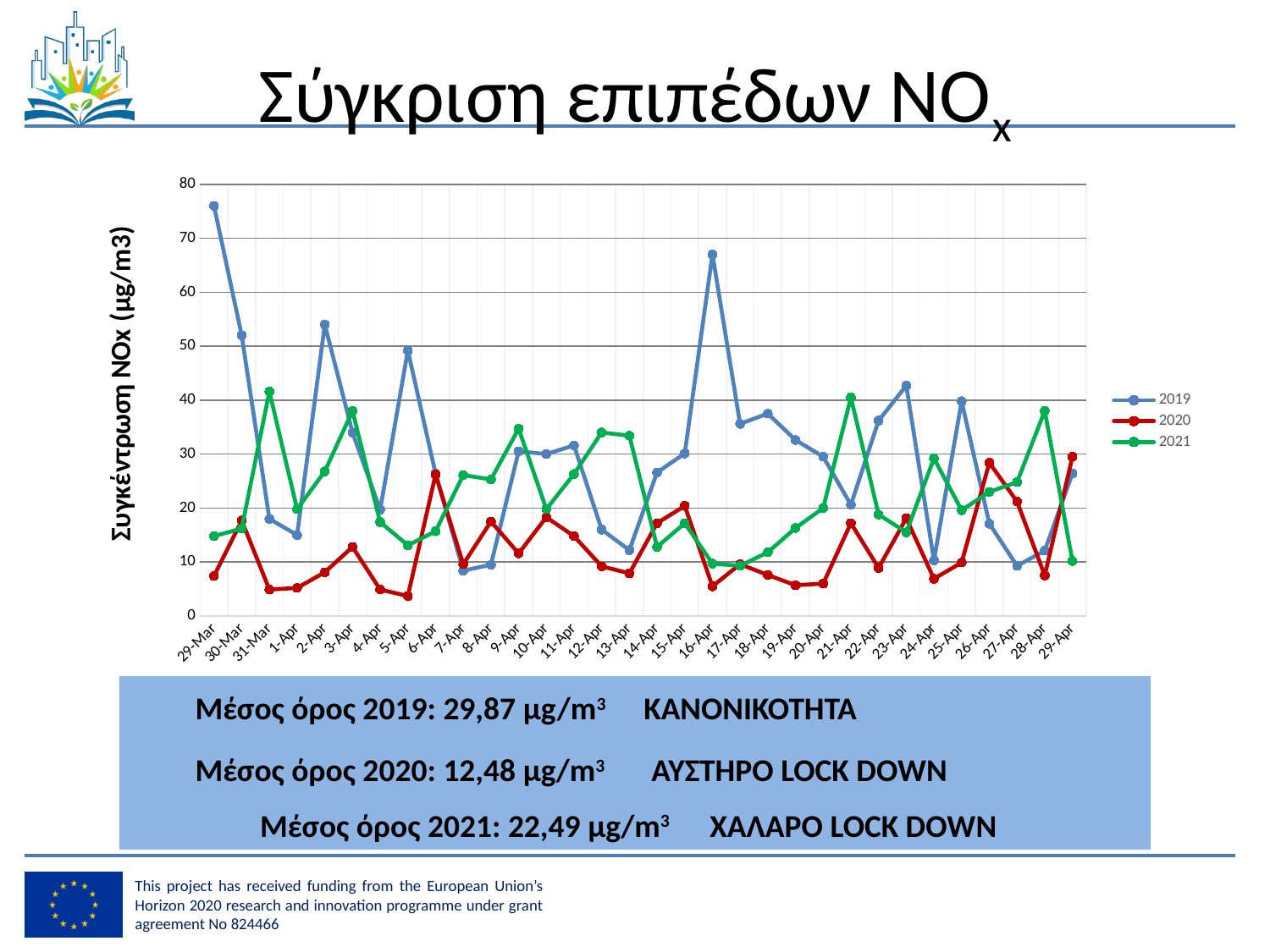
Is the 2019 value on 16-Apr greater or less than 60? greater How many series does the legend list? 3 How many dates are shown along the x axis? 32 What kind of chart is shown on the slide? line chart Is the 2019 value on 29-Mar greater or less than 70? greater What is the title of the y axis? Συγκέντρωση NOx (μg/m3) Is the 2020 value on 29-Mar greater or less than 10? less Which series reaches the highest value anywhere on the chart? 2019 On which date does the 2019 series reach its highest value? 29-Mar Does the 2019 series rise or fall from 29-Mar to 31-Mar? fall